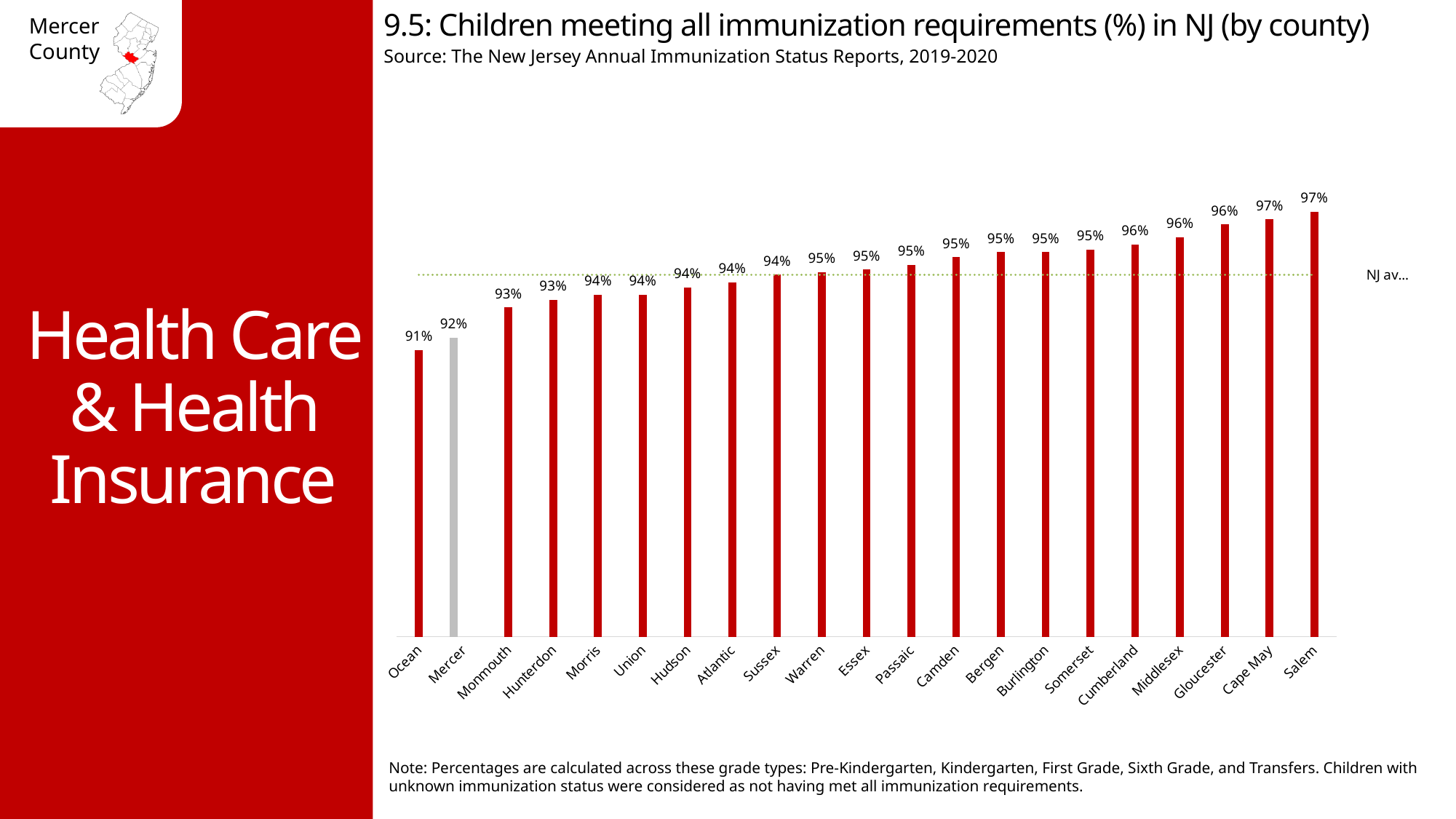
What kind of chart is shown on the slide? Bar chart What is the value shown for Ocean County? 91% What is the value shown for Salem County? 97% What percentage of children in Mercer County met all immunization requirements? 92% Do the values rise or fall moving from left to right along the x axis? Rise Which has a higher value, Monmouth or Cumberland? Cumberland What is the difference in percentage points between Mercer and Ocean counties? 1 percentage point What is the difference in percentage points between Salem and Ocean counties? 6 percentage points Which county has the lowest percentage of children meeting all immunization requirements? Ocean What is the value shown for Cumberland County? 96% Which county's bar is coloured grey instead of red? Mercer How many counties are shown on the chart? 21